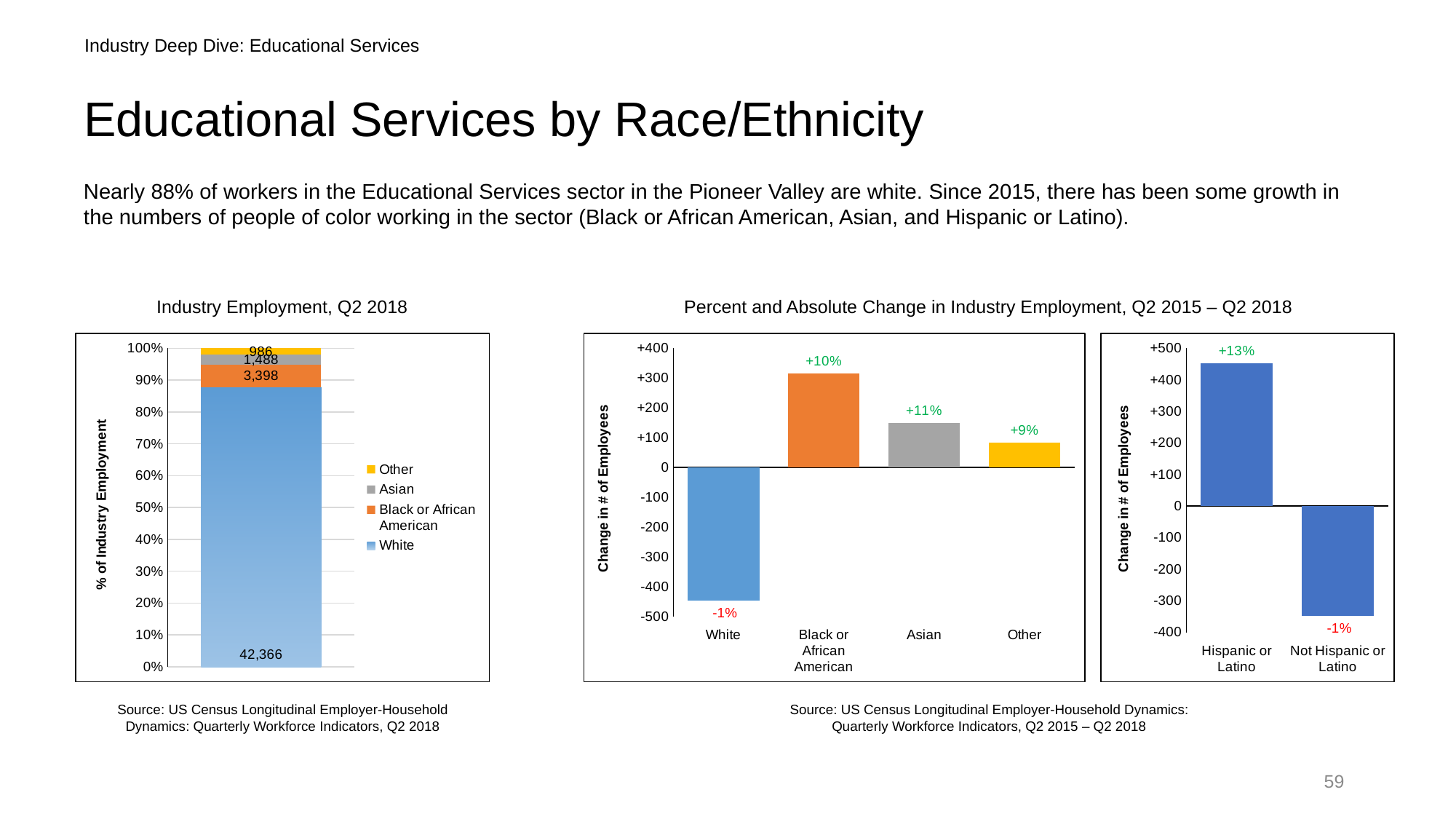
In the Industry Employment, Q2 2018 chart, what is the difference between the Black or African American and Asian employee counts? 1,910 In the Percent and Absolute Change chart by race, how many categories are shown on the x axis? 4 In the Percent and Absolute Change chart by ethnicity, what is the percent change for Hispanic or Latino employees? +13% In the Percent and Absolute Change chart by race, is the change in number of White employees greater or less than -400? less In the Percent and Absolute Change chart by race, is the change in number of Black or African American employees greater or less than +300? greater In the Industry Employment, Q2 2018 chart, what is the number of Asian employees? 1,488 In the Industry Employment, Q2 2018 chart, what is the number of Black or African American employees? 3,398 In the Percent and Absolute Change chart by ethnicity, is the change in number of Not Hispanic or Latino employees greater or less than -300? less In the Industry Employment, Q2 2018 chart, how many series does the legend list? 4 In the Industry Employment, Q2 2018 chart, how many White employees are shown? 42,366 In the Percent and Absolute Change chart by race, what is the percent change for Black or African American employees? +10% In the Percent and Absolute Change chart by race, which category has the highest percent change? Asian